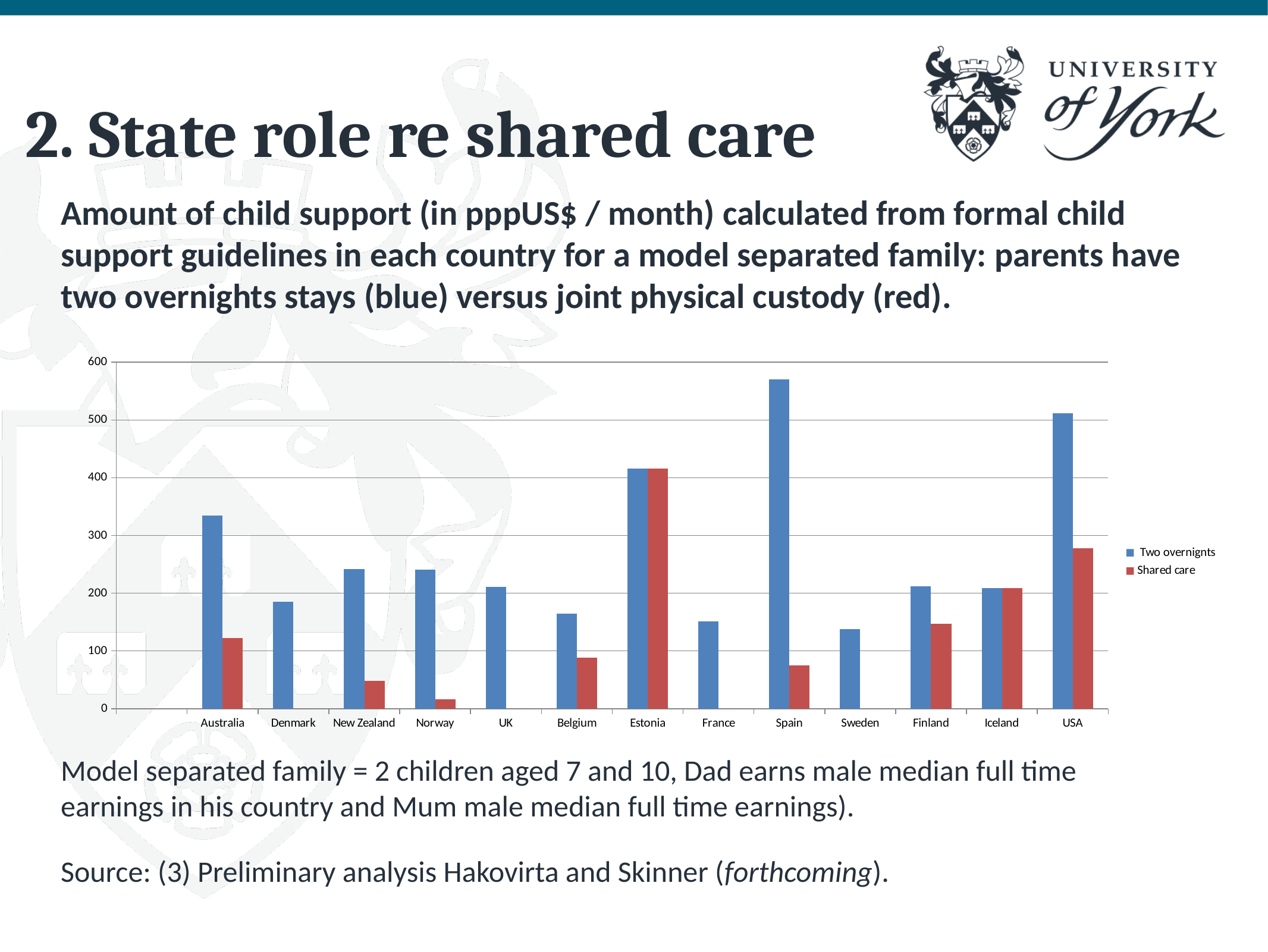
How many countries are shown on the x axis of the chart? 13 Is the Two overnights value for Belgium greater or less than 200? less What kind of chart is shown on the slide? bar chart Which country has the highest Two overnights value? Spain Is the Shared care value for Norway greater or less than 100? less Is the Two overnights value for Australia greater or less than 300? greater How many series does the chart legend list? 2 Which is larger, the Two overnights value for Spain or for USA? Spain Which country has the highest Shared care value? Estonia Which series is shown in red in the chart? Shared care